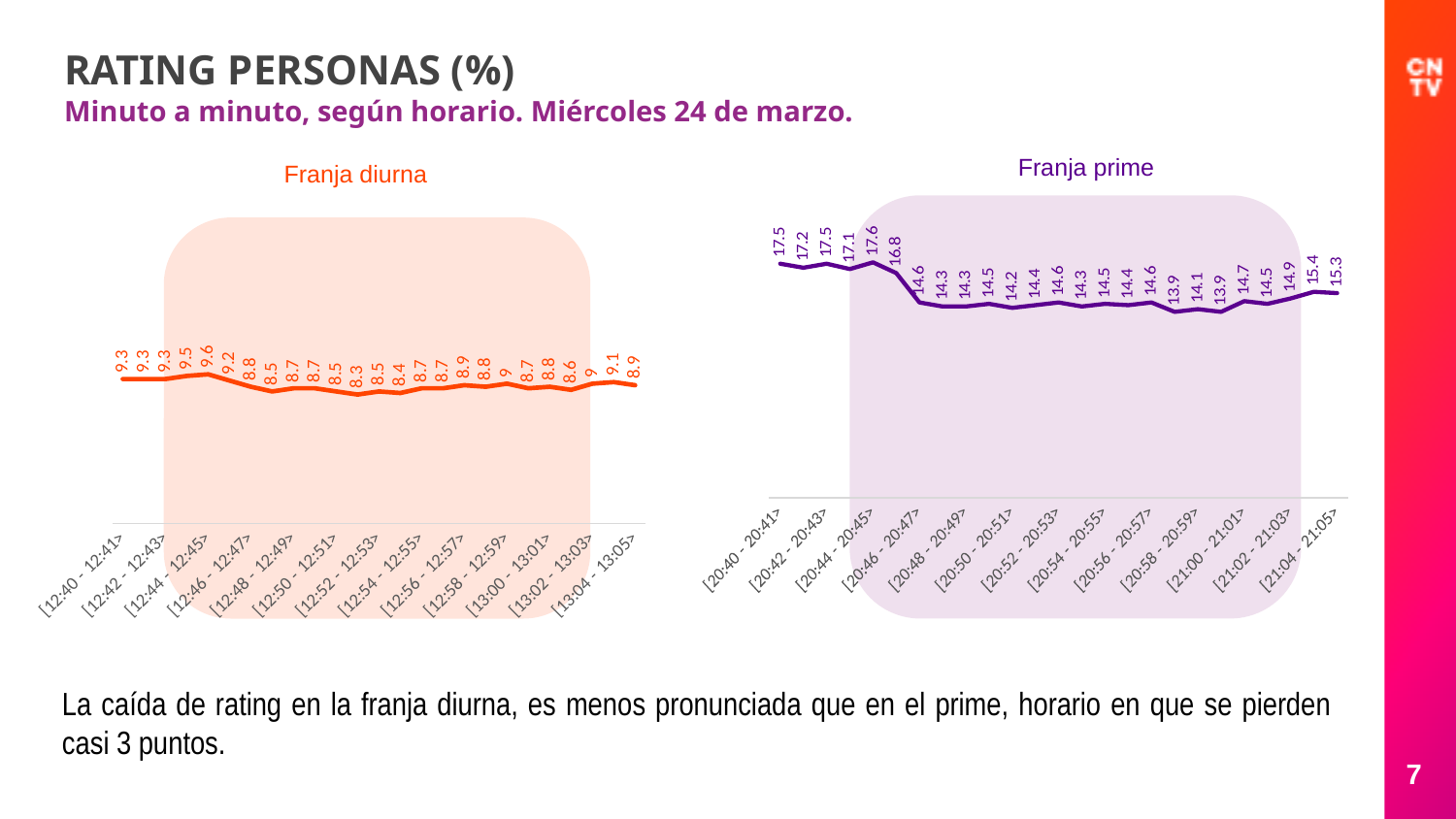
In the Franja diurna chart, what is the lowest rating value plotted? 8.3 In the Franja prime chart, what is the difference between the highest value (17.6) and the lowest value (13.9)? 3.7 What type of chart is used for Franja diurna and Franja prime? Line chart Which chart has the higher starting value: Franja diurna or Franja prime? Franja prime In the Franja prime chart, what is the highest rating value plotted? 17.6 In the Franja diurna chart, what is the rating value for the first interval, [12:40 - 12:41>? 9.3 In the Franja prime chart, do the values overall rise or fall from the first interval to the last? Fall In the Franja diurna chart, what is the highest rating value plotted? 9.6 In the Franja prime chart, what is the lowest rating value plotted? 13.9 In the Franja prime chart, how much lower is the last value ([21:04 - 21:05>) than the first value ([20:40 - 20:41>)? 2.2 In the Franja prime chart, what is the rating value for the last interval, [21:04 - 21:05>? 15.3 In the Franja prime chart, what is the rating value for the first interval, [20:40 - 20:41>? 17.5